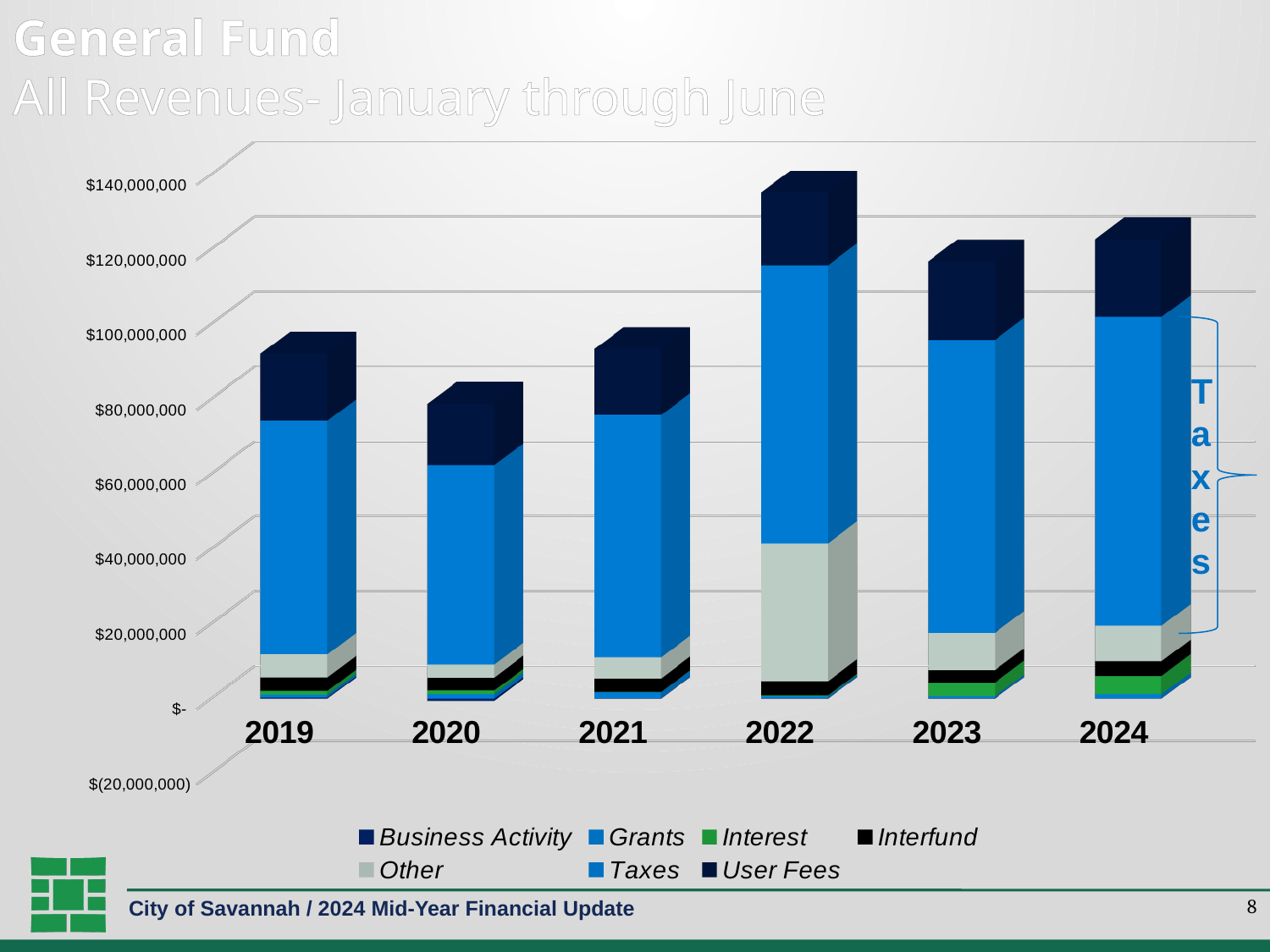
How many years are shown on the x axis of the chart? 6 Is the total revenue bar for 2020 greater or less than $100,000,000? less What is the title of the chart on the slide? General Fund All Revenues- January through June How many series does the chart's legend list? 7 Which year has the highest total revenue bar? 2022 Is the total revenue bar for 2024 greater or less than $100,000,000? greater Which year has the taller total revenue bar, 2022 or 2023? 2022 Which year has the lowest total revenue bar? 2020 Which year has the taller total revenue bar, 2019 or 2020? 2019 What kind of chart is shown on the slide? Stacked bar chart Do the total revenue bars rise or fall from 2020 to 2022? rise Is the total revenue bar for 2022 greater or less than $120,000,000? greater